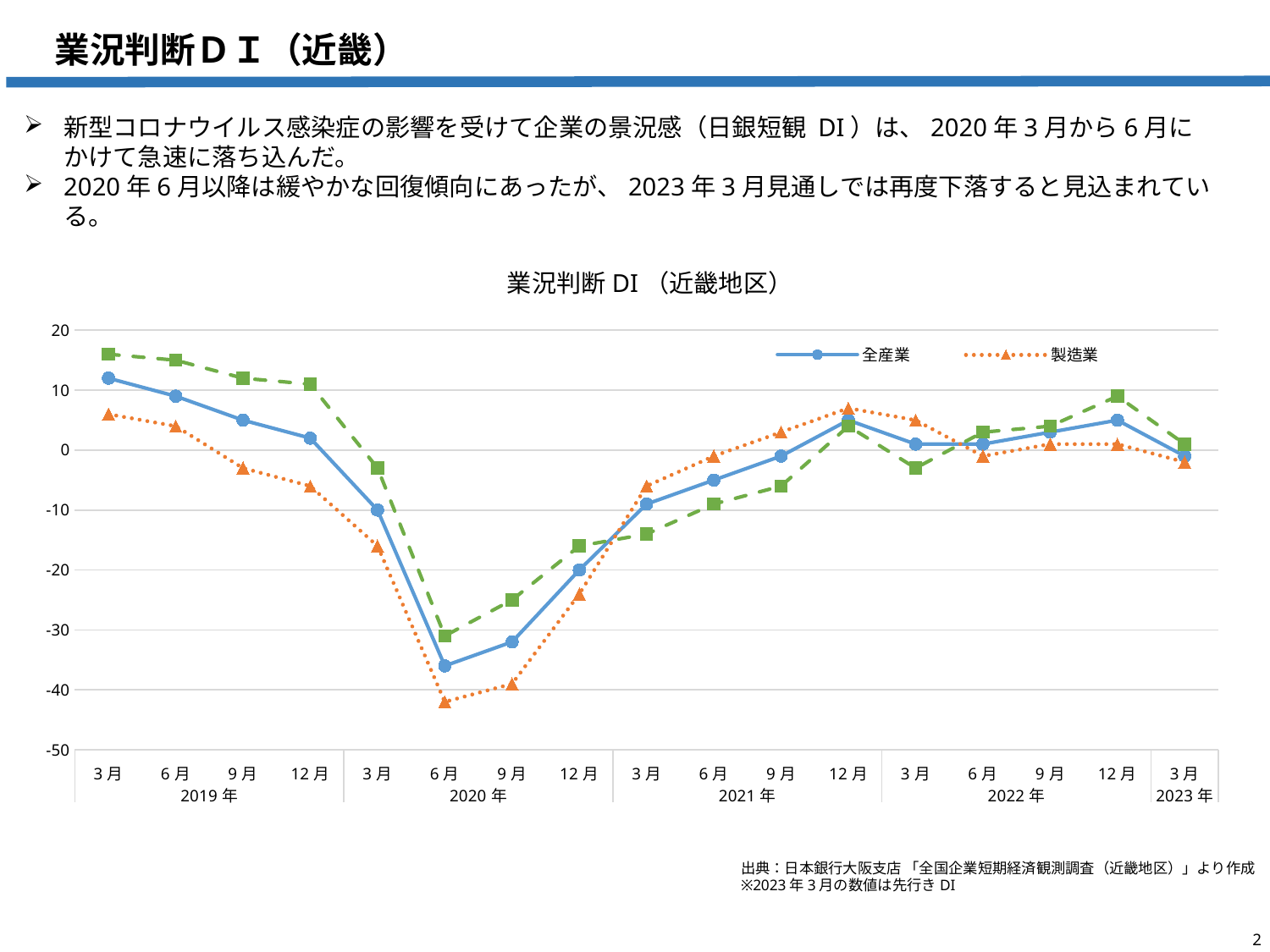
What kind of chart is shown on the slide? line chart How many time points are plotted along the x axis of the chart? 17 How many series does the chart's legend list? 2 At which time point does the 全産業 series reach its highest value? 2019年3月 Does the 全産業 series rise or fall from 2019年3月 to 2020年6月? fall What is the title of the chart? 業況判断DI（近畿地区） Is the value for 製造業 in 2020年6月 greater or less than -40? less Is the value for 全産業 in 2019年3月 greater or less than 10? greater In 2019年3月, which series has the higher value, 全産業 or 製造業? 全産業 Is the value for 全産業 in 2020年9月 greater or less than -30? less At which time point does the 製造業 series reach its lowest value? 2020年6月 At which time point does the 全産業 series reach its lowest value? 2020年6月